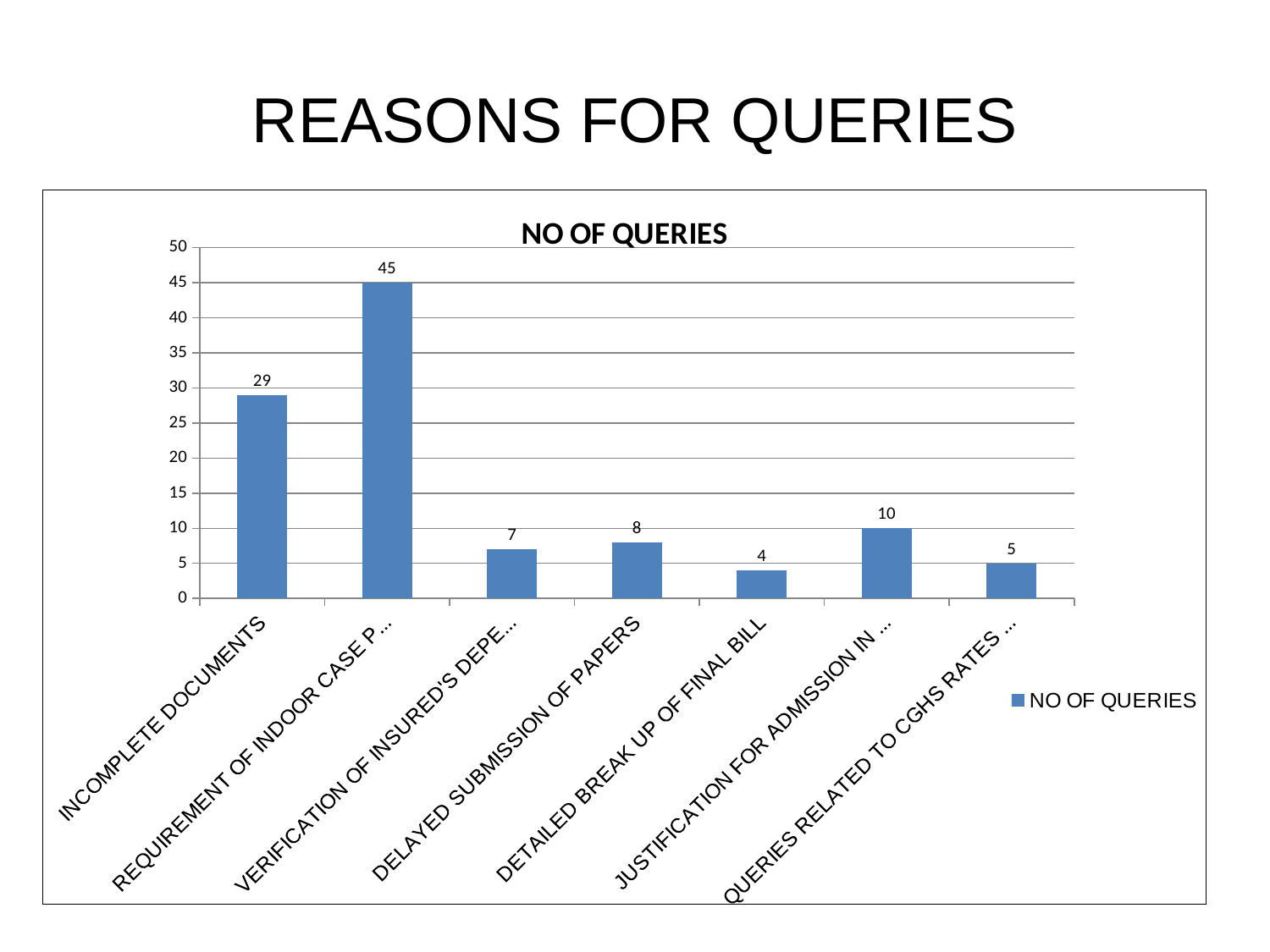
What is the number of queries for INCOMPLETE DOCUMENTS? 29 Which category has the lowest number of queries? DETAILED BREAK UP OF FINAL BILL What is the number of queries for DELAYED SUBMISSION OF PAPERS? 8 Which category has the highest number of queries? REQUIREMENT OF INDOOR CASE P... Is the value for INCOMPLETE DOCUMENTS greater or less than 25? greater What is the title of the chart? NO OF QUERIES How many categories are shown on the x axis of the chart? 7 What is the difference in number of queries between INCOMPLETE DOCUMENTS and DELAYED SUBMISSION OF PAPERS? 21 Which has more queries, DELAYED SUBMISSION OF PAPERS or DETAILED BREAK UP OF FINAL BILL? DELAYED SUBMISSION OF PAPERS What type of chart is shown on the slide? Bar chart How many series does the legend list? 1 What is the number of queries for DETAILED BREAK UP OF FINAL BILL? 4